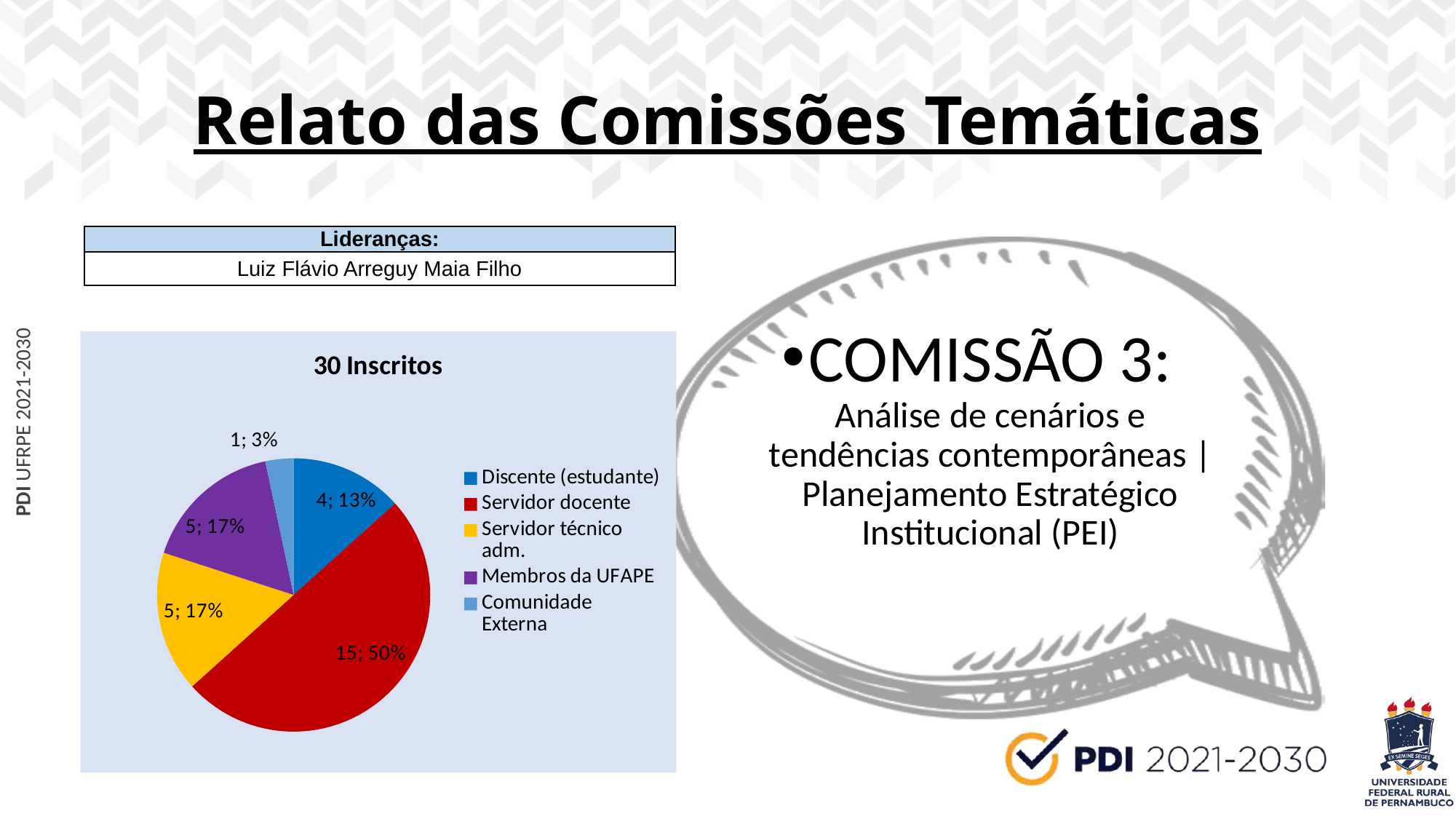
Which category has the largest slice? Servidor docente What kind of chart is shown on the slide? Pie chart What is the value for Discente (estudante)? 4 Which category has the smallest slice? Comunidade Externa What is the value for Comunidade Externa? 1 What is the title of the chart? 30 Inscritos What share of the pie does Membros da UFAPE represent? 17% What is the value for Servidor docente? 15 What share of the pie does Servidor docente represent? 50% How many entries does the chart legend list? 5 What is the difference between the values for Servidor docente and Discente (estudante)? 11 How many categories does the pie chart have? 5